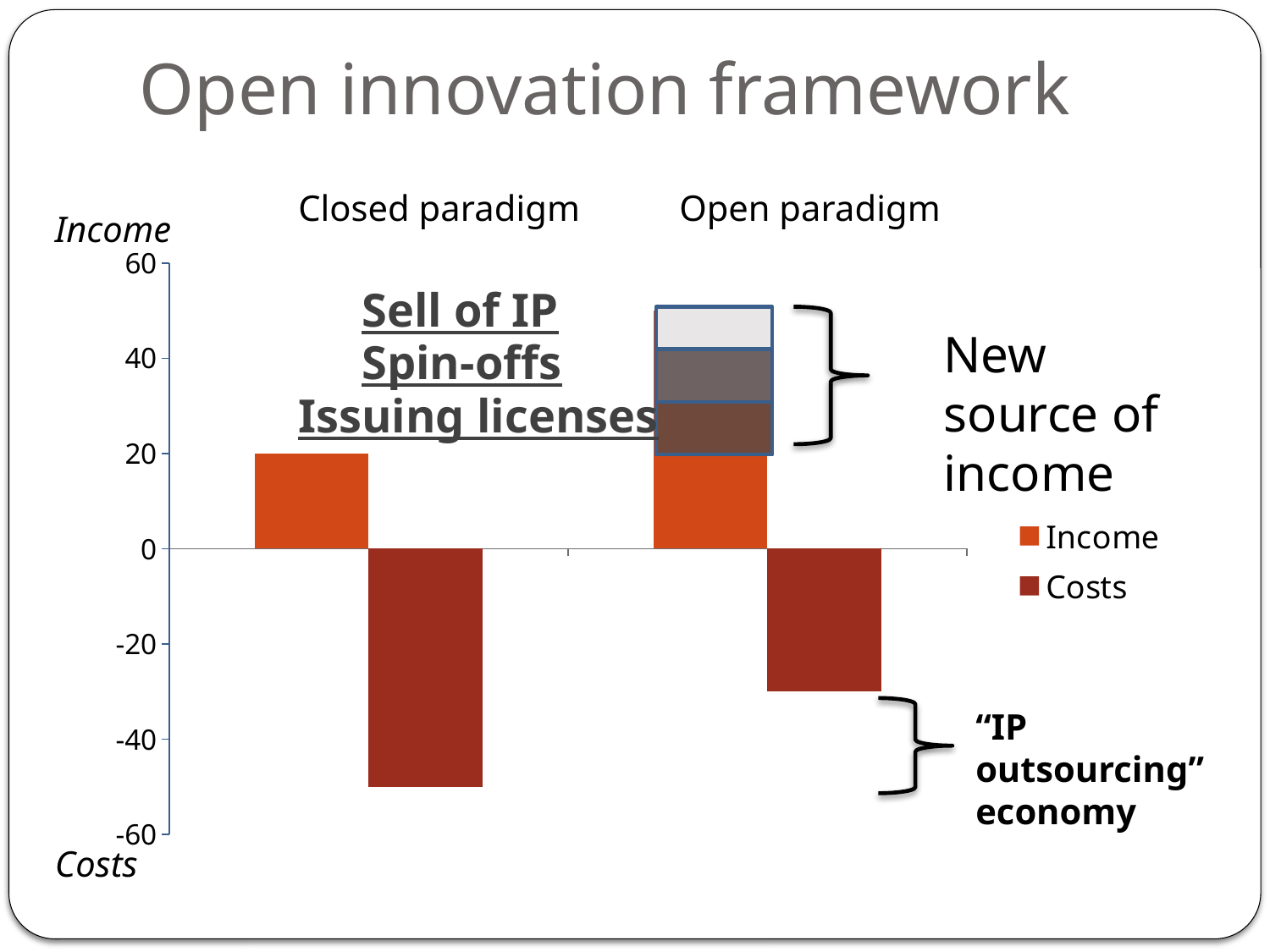
Is the Costs value for the Closed paradigm greater or less than -40? less How many categories (paradigms) are shown on the x axis? 2 What is the title of the slide containing the chart? Open innovation framework What is the Income value for the Closed paradigm? 20 What type of chart is shown on the slide? bar chart What are the two series named in the legend? Income and Costs Which paradigm has the longer Costs bar (the more negative Costs value)? Closed paradigm Is the Costs value for the Open paradigm greater or less than -40? greater Is the Costs value for the Open paradigm greater or less than -20? less How many series does the legend list? 2